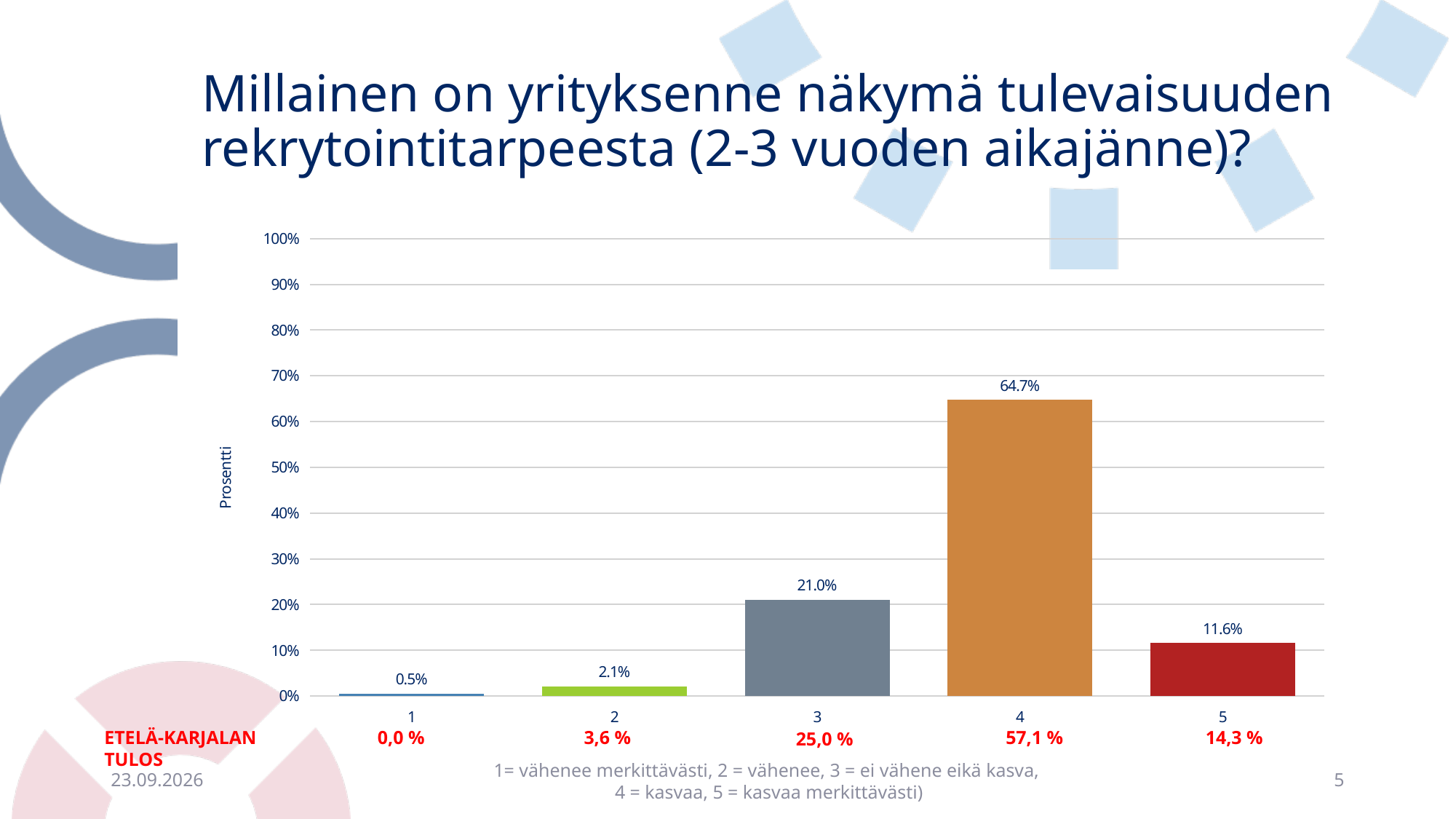
What is the label of the y axis? Prosentti Which is larger, the value for category 3 or the value for category 5? category 3 What kind of chart is shown on the slide? bar chart Which category has the lowest value? 1 How many categories are shown on the x axis? 5 What is the value for category 1? 0.5% Which category has the highest value? 4 What is the value for category 4? 64.7% What is the value for category 5? 11.6% Is the value for category 4 greater or less than 60%? greater What is the value for category 3? 21.0% What is the difference between the values for category 4 and category 3? 43.7%